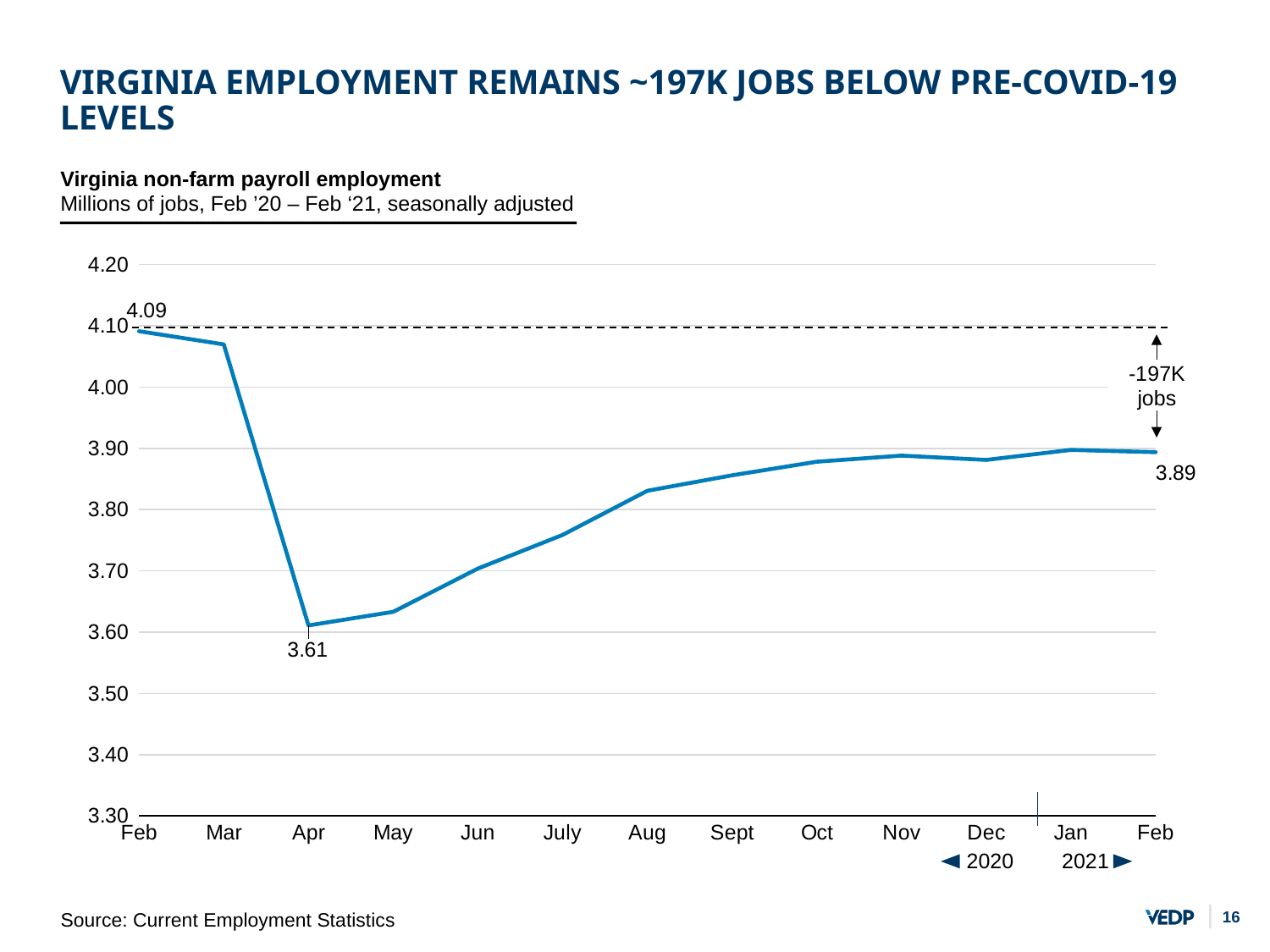
What was Virginia non-farm payroll employment (millions of jobs) in Feb 2021? 3.89 What was Virginia non-farm payroll employment (millions of jobs) in Apr 2020? 3.61 What type of chart is shown on the slide? Line chart Is the value for May 2020 greater or less than 3.70? less Is the value for Aug 2020 greater or less than 3.80? greater In which month was Virginia non-farm payroll employment highest? Feb 2020 What is the difference in millions of jobs between Feb 2020 and Feb 2021? 0.20 How many monthly data points are plotted on the chart? 13 What was Virginia non-farm payroll employment (millions of jobs) in Feb 2020? 4.09 By how many millions of jobs did employment fall from Feb 2020 to Apr 2020? 0.48 Which is larger, employment in Apr 2020 or in Feb 2021? Feb 2021 In which month was Virginia non-farm payroll employment lowest? Apr 2020